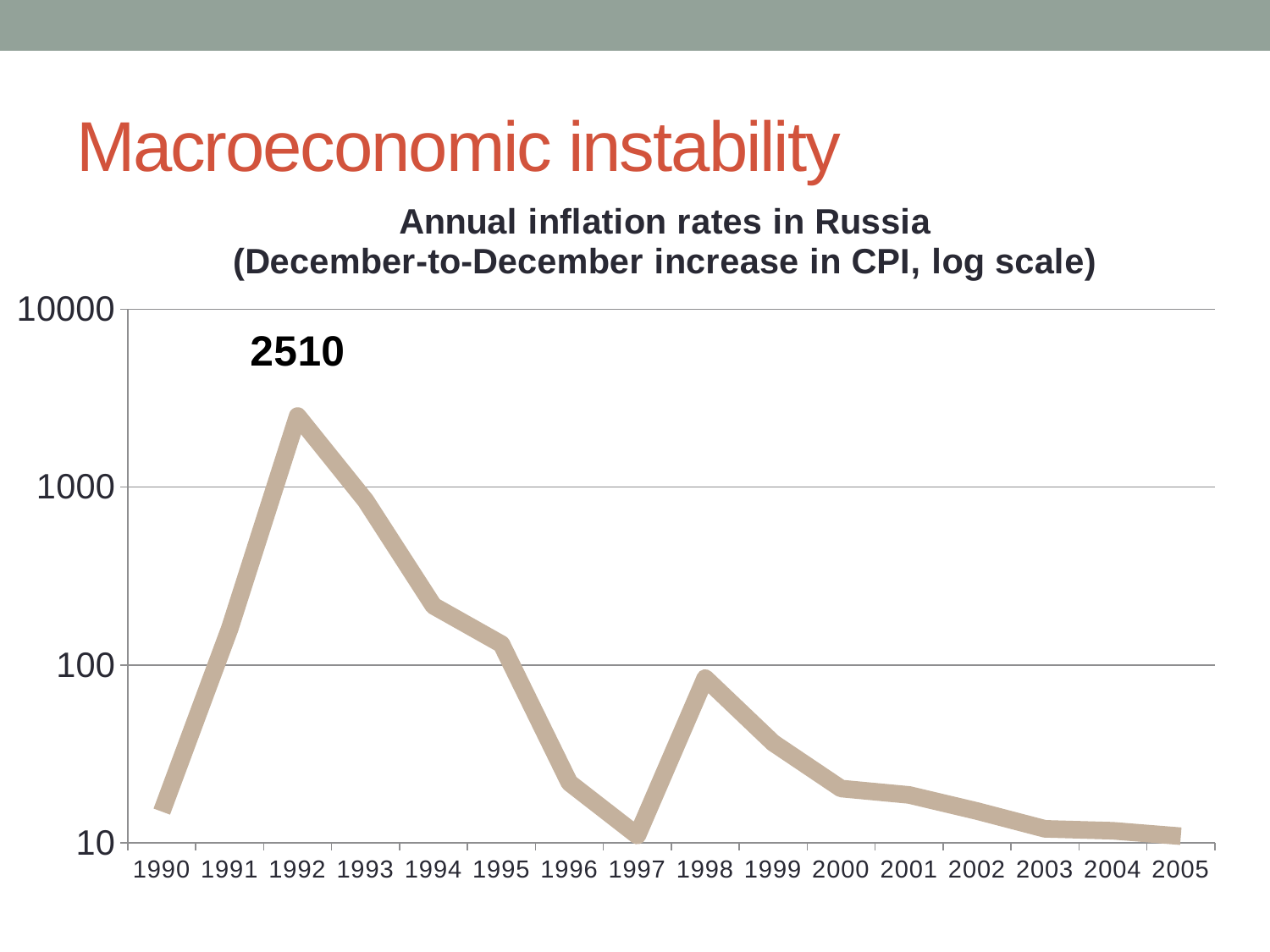
How many years are plotted on the x axis? 16 What is the annual inflation rate shown for 1992? 2510 What is the title of the chart? Annual inflation rates in Russia (December-to-December increase in CPI, log scale) Is the value for 1993 greater or less than 1000? less Do the values rise or fall from 1992 to 1997? fall Is the value for 1994 greater or less than 100? greater Is the value for 1990 greater or less than 100? less Which year has the larger inflation rate, 1994 or 1996? 1994 Which year has the highest annual inflation rate? 1992 Do the values rise or fall from 1990 to 1992? rise What type of chart is shown on the slide? line chart